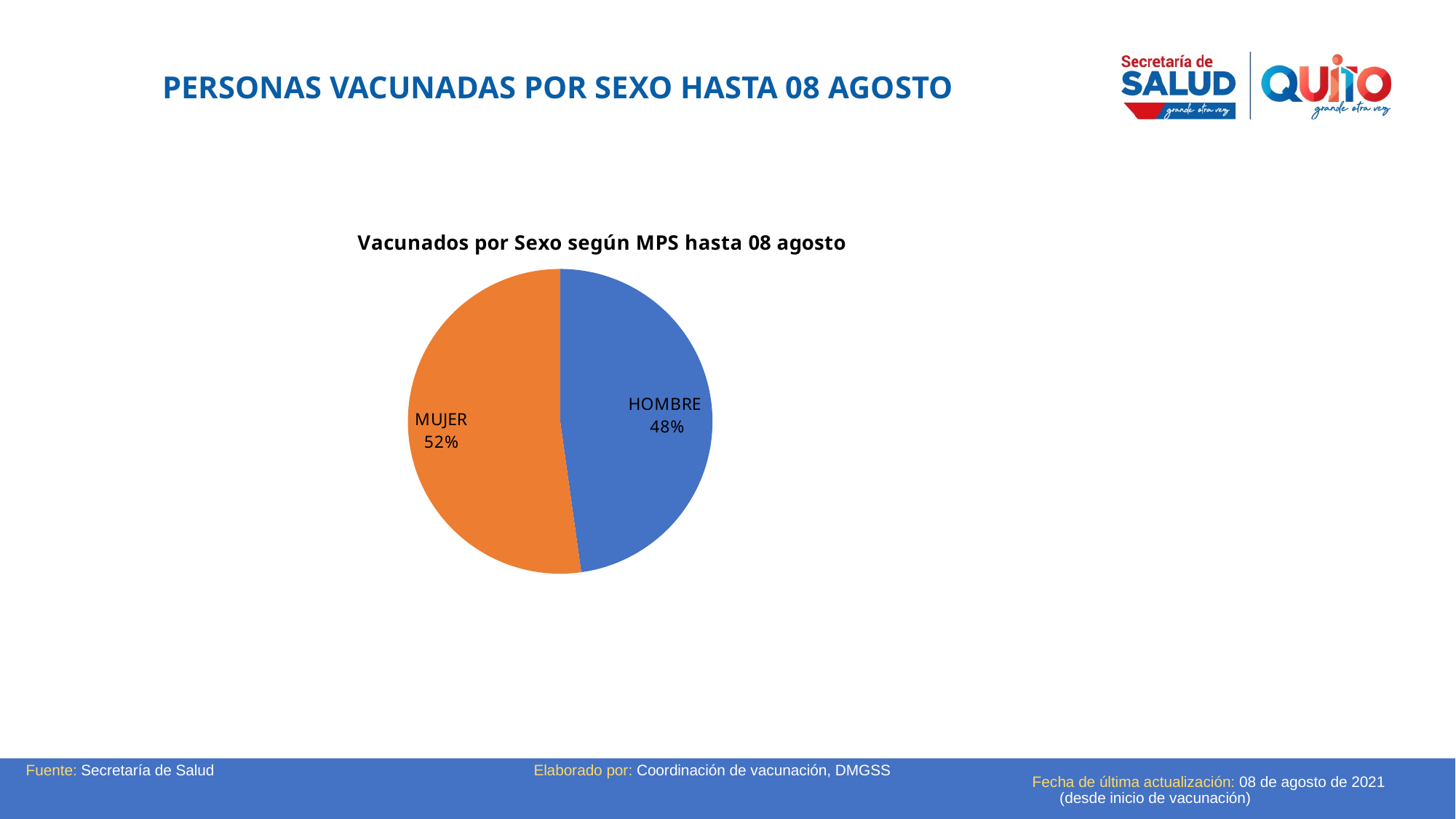
What is the difference in percentage points between the MUJER and HOMBRE shares? 4 percentage points Which category has the largest share of the pie? MUJER What is the title of the chart? Vacunados por Sexo según MPS hasta 08 agosto What colour is the HOMBRE slice of the pie? Blue Is the share for MUJER greater or less than 50%? greater What share of the pie does MUJER represent? 52% Is the share for HOMBRE greater or less than 50%? less Which category has the smallest share of the pie? HOMBRE How many categories are shown in the pie chart? 2 What kind of chart is shown on the slide? Pie chart What share of the pie does HOMBRE represent? 48% Which is larger, the share for MUJER or the share for HOMBRE? MUJER